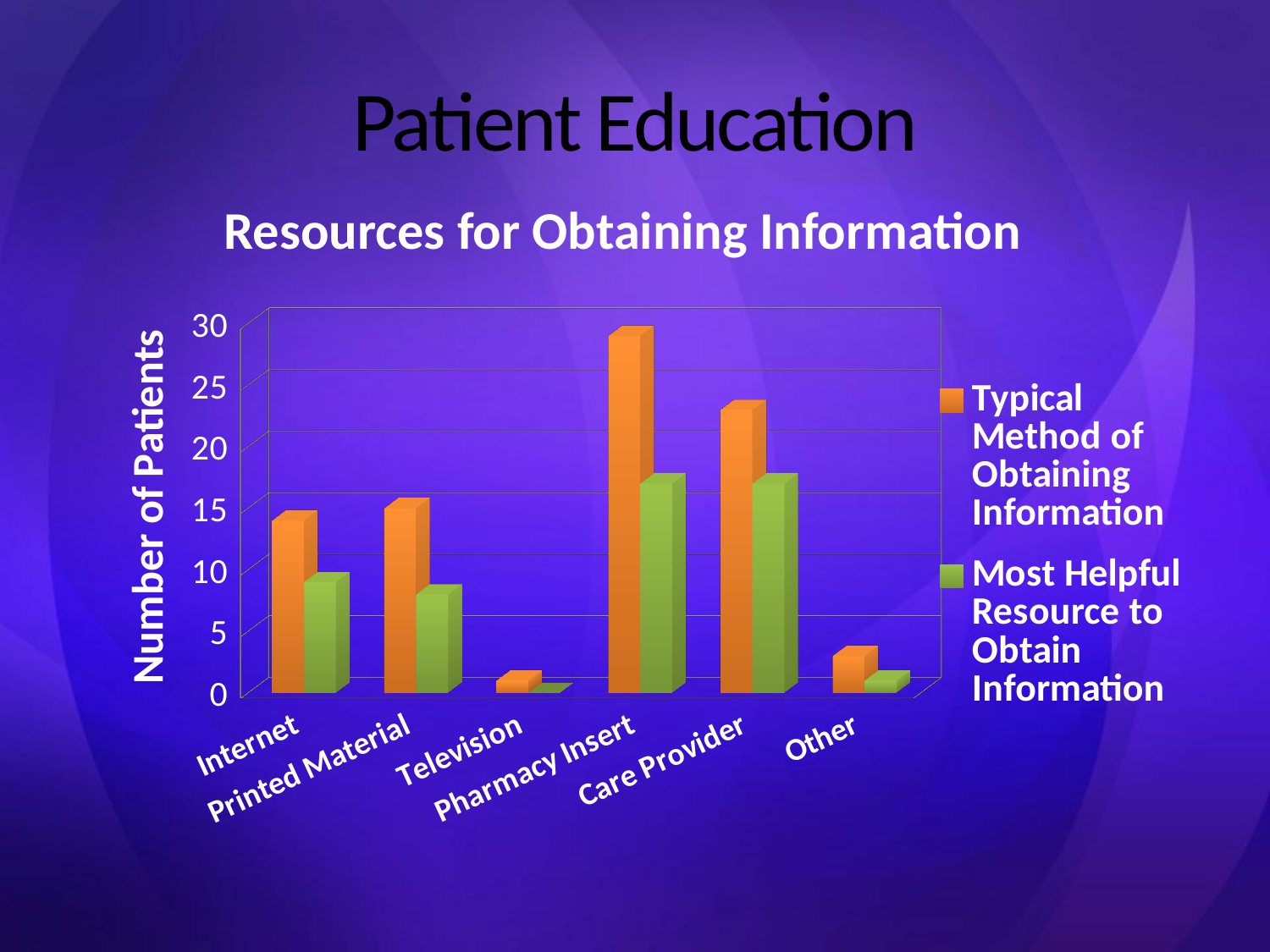
Is the Typical Method of Obtaining Information value for Pharmacy Insert greater or less than 25? greater What kind of chart is shown on the slide? bar chart Is the Typical Method of Obtaining Information value for Care Provider greater or less than 20? greater Which category has the highest value for Typical Method of Obtaining Information? Pharmacy Insert Which category has the lowest value for Typical Method of Obtaining Information? Television How many series does the chart's legend list? 2 How many categories are shown on the x axis of the chart? 6 What is the label of the chart's vertical axis? Number of Patients Is the Typical Method of Obtaining Information value for Other greater or less than 5? less For Internet, which is larger: Typical Method of Obtaining Information or Most Helpful Resource to Obtain Information? Typical Method of Obtaining Information Which has a larger Typical Method of Obtaining Information value: Care Provider or Printed Material? Care Provider